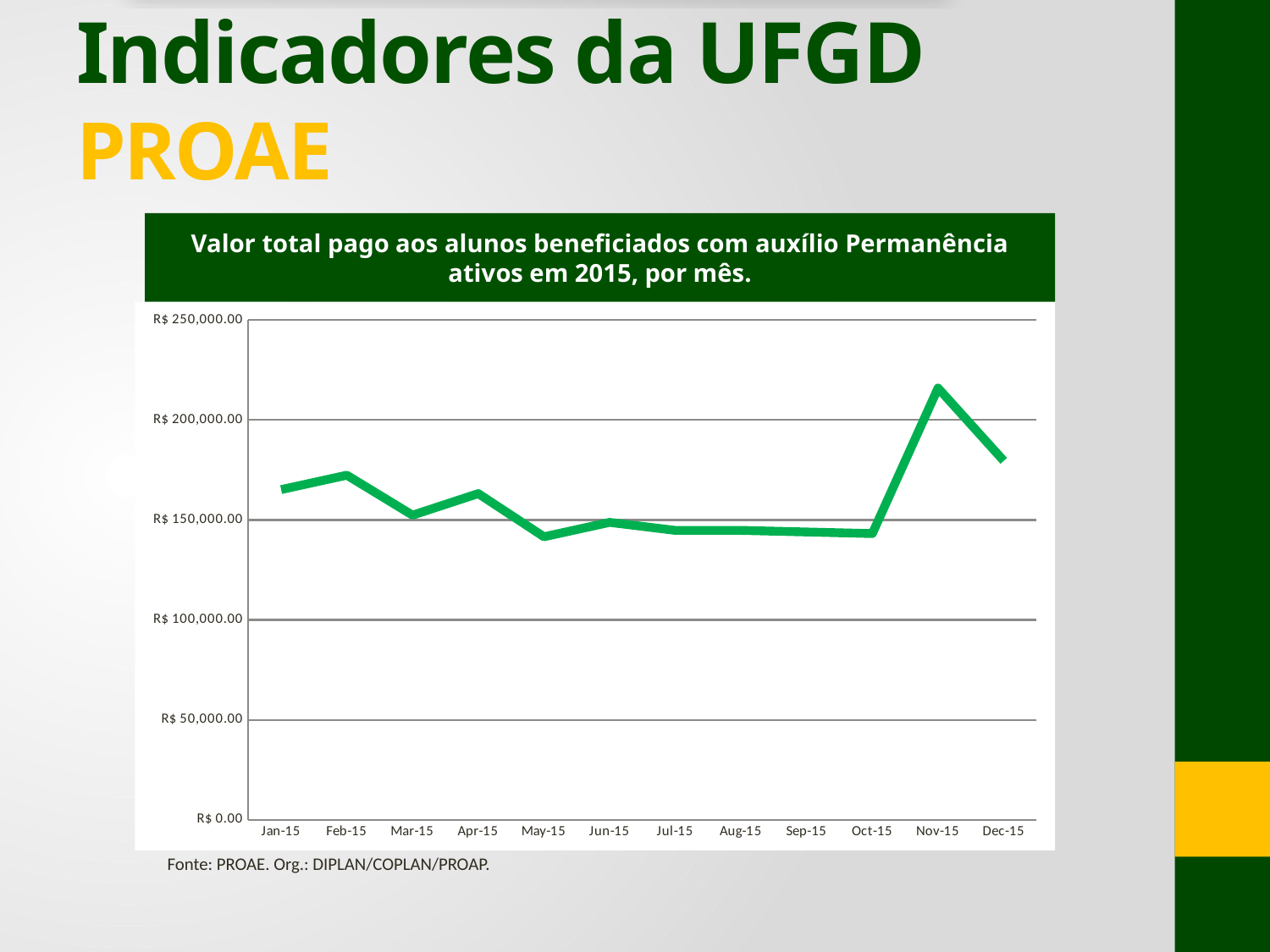
How many months are plotted along the x axis? 12 Which month has the highest value? Nov-15 Is the value for Jan-15 greater or less than R$ 150,000.00? greater Does the value rise or fall from Oct-15 to Nov-15? rise Is the value for Dec-15 greater or less than R$ 200,000.00? less What kind of chart is shown on the slide? line chart What source is cited below the chart? Fonte: PROAE. Org.: DIPLAN/COPLAN/PROAP. Is the value for Nov-15 greater or less than R$ 200,000.00? greater Which is larger, the value for Nov-15 or the value for Dec-15? Nov-15 Which is larger, the value for Feb-15 or the value for Mar-15? Feb-15 What is the title of the chart? Valor total pago aos alunos beneficiados com auxílio Permanência ativos em 2015, por mês.